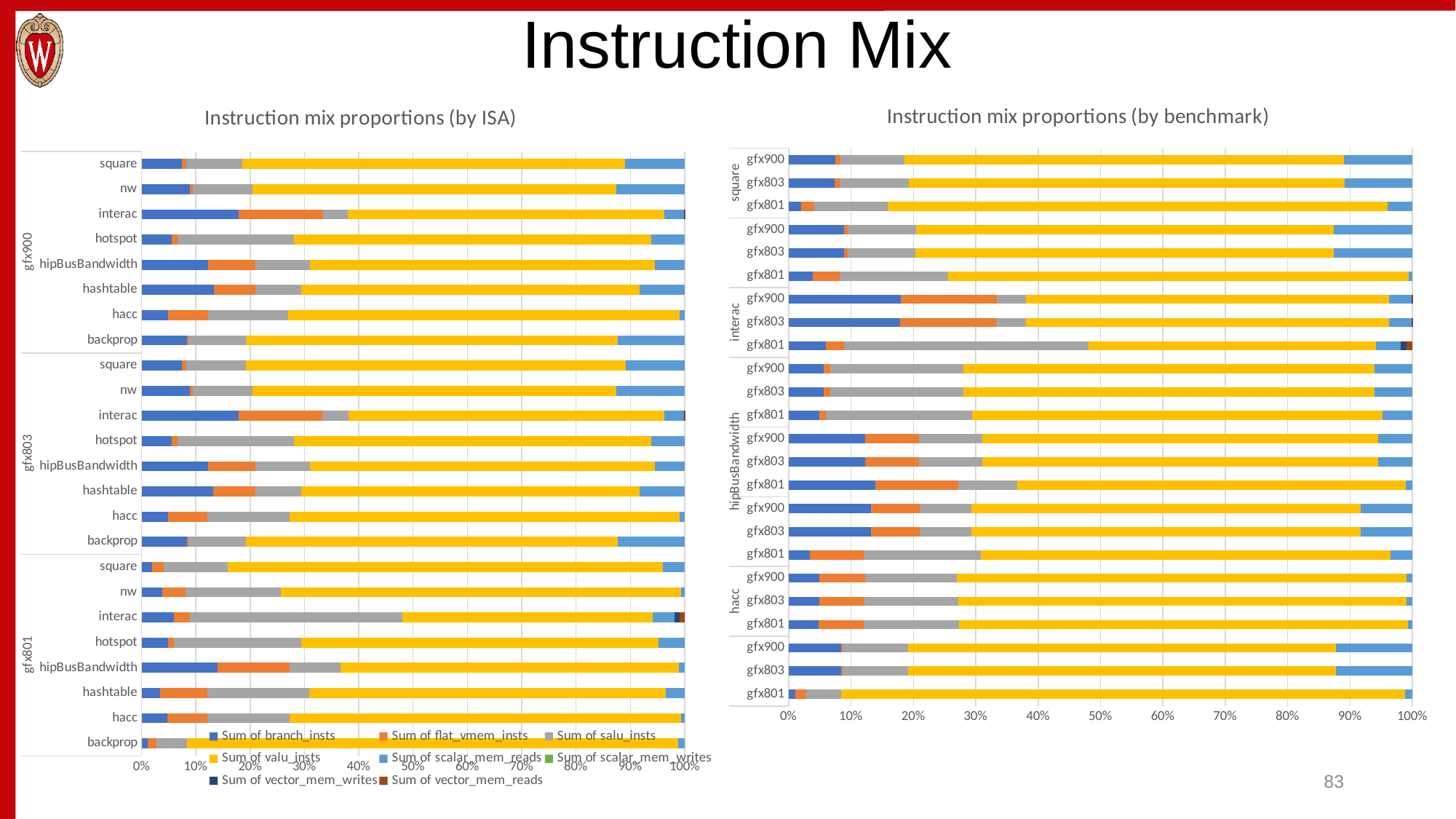
In the 'Instruction mix proportions (by ISA)' chart, which benchmark under gfx900 has the largest Sum of branch_insts share? interac How many ISA groups are shown on the vertical axis of the 'Instruction mix proportions (by ISA)' chart? 3 In the 'Instruction mix proportions (by ISA)' chart, under gfx900, which has the larger Sum of branch_insts share: interac or hacc? interac What is the title of the chart on the right side of the slide? Instruction mix proportions (by benchmark) What is the maximum value shown on the horizontal axis of the 'Instruction mix proportions (by benchmark)' chart? 100% What kind of chart is the 'Instruction mix proportions (by ISA)' chart? Stacked bar chart How many series does the legend of the 'Instruction mix proportions (by ISA)' chart list? 8 In the 'Instruction mix proportions (by ISA)' chart, how many benchmarks are listed under gfx900? 8 In the 'Instruction mix proportions (by ISA)' chart, which series is shown in yellow? Sum of valu_insts How many bars are plotted in the 'Instruction mix proportions (by ISA)' chart? 24 In the 'Instruction mix proportions (by ISA)' chart, is the Sum of branch_insts share for hacc under gfx900 greater or less than 10%? less In the 'Instruction mix proportions (by ISA)' chart, is the Sum of branch_insts share for interac under gfx900 greater or less than 10%? greater